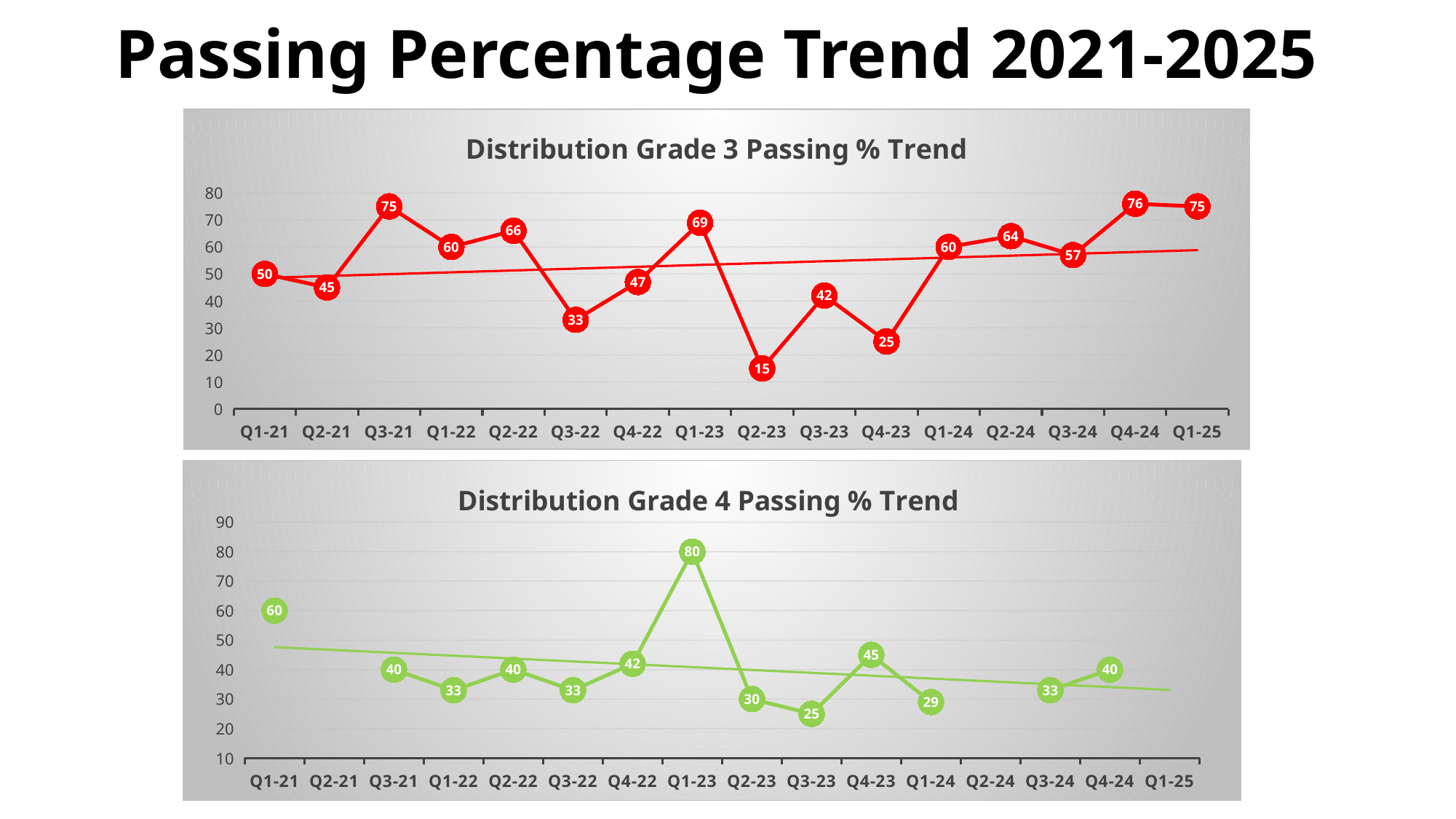
In the Distribution Grade 4 Passing % Trend chart, which quarter has the lowest value? Q3-23 In the Distribution Grade 3 Passing % Trend chart, what is the difference between the values for Q3-21 and Q3-22? 42 In the Distribution Grade 4 Passing % Trend chart, what is the value for Q1-23? 80 What kind of chart is the Distribution Grade 4 Passing % Trend chart? Line chart What colour is the data line in the Distribution Grade 3 Passing % Trend chart? Red In the Distribution Grade 4 Passing % Trend chart, what is the difference between the values for Q1-21 and Q1-24? 31 In the Distribution Grade 3 Passing % Trend chart, which is larger, the value for Q1-22 or the value for Q2-22? Q2-22 How many quarters are shown on the x axis of the Distribution Grade 3 Passing % Trend chart? 16 In the Distribution Grade 3 Passing % Trend chart, what is the value for Q2-23? 15 In the Distribution Grade 4 Passing % Trend chart, does the trend line rise or fall from left to right? Fall In the Distribution Grade 3 Passing % Trend chart, which quarter has the lowest value? Q2-23 In the Distribution Grade 3 Passing % Trend chart, which quarter has the highest value? Q4-24